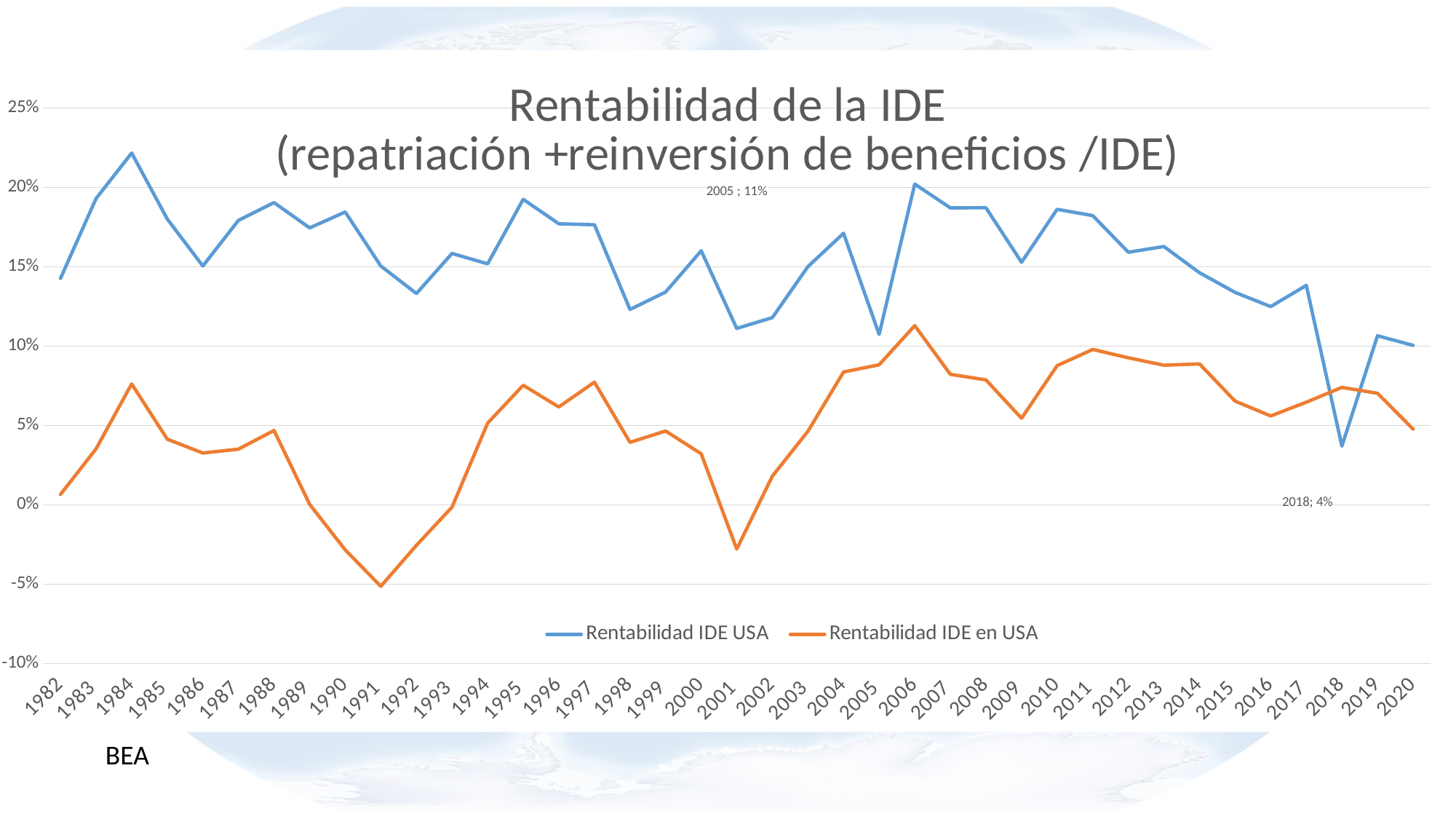
What is the value of Rentabilidad IDE USA in 2005, as printed on the chart? 11% In which year does the Rentabilidad IDE USA series reach its highest value? 1984 How many series does the legend list? 2 In which year does the Rentabilidad IDE en USA series reach its lowest value? 1991 In which year does the Rentabilidad IDE USA series reach its lowest value? 2018 Is the value of Rentabilidad IDE en USA in 2001 greater or less than 0%? less Is the value of Rentabilidad IDE USA in 1982 greater or less than 10%? greater How many years are plotted along the x axis? 39 What kind of chart is shown on the slide? line chart In 2020, which series has the higher value, Rentabilidad IDE USA or Rentabilidad IDE en USA? Rentabilidad IDE USA What is the value of Rentabilidad IDE USA in 2018, as printed on the chart? 4% Does the Rentabilidad IDE en USA series rise or fall from 1988 to 1991? fall